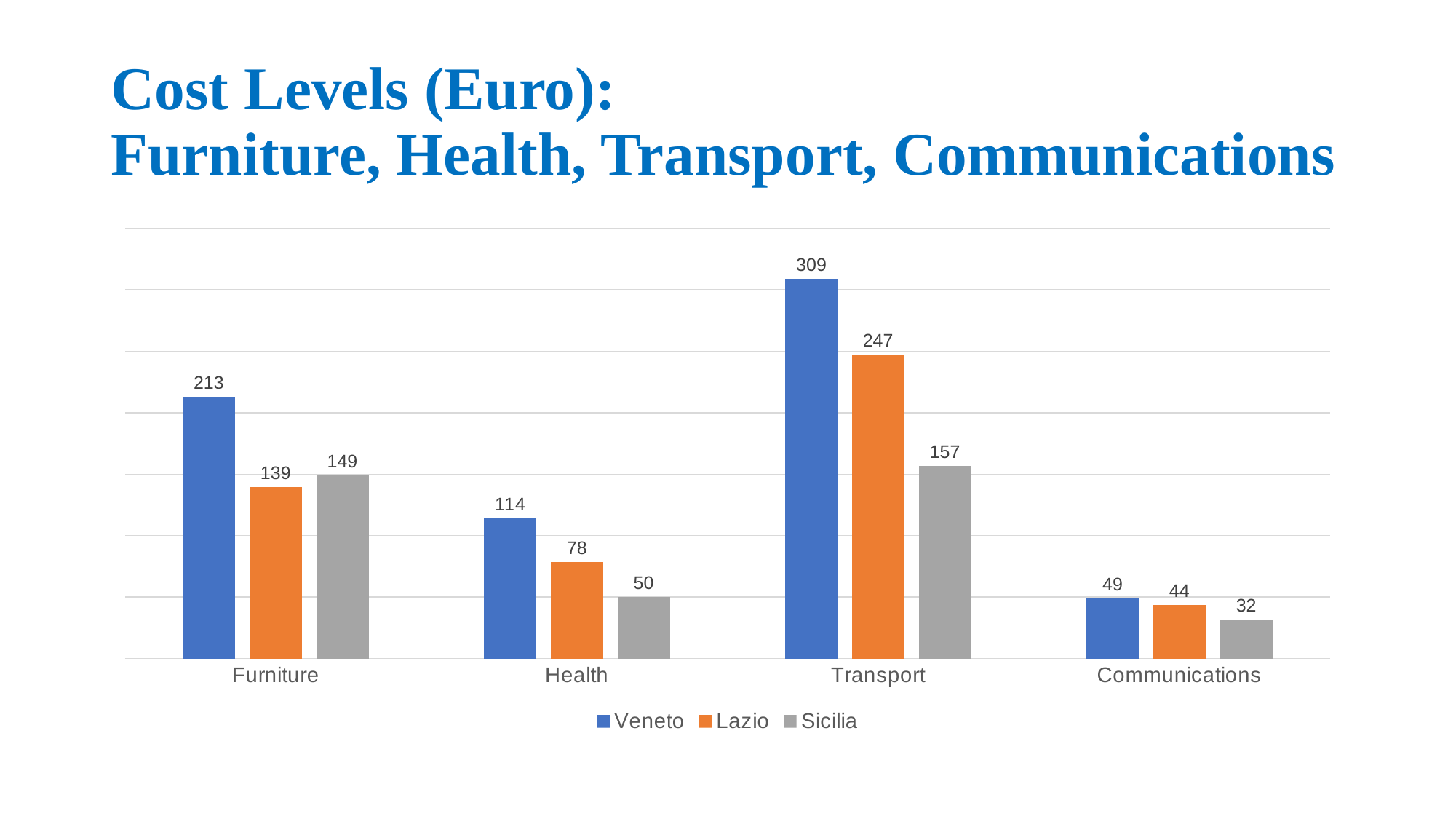
Which series is shown in orange in the legend? Lazio What kind of chart is shown on the slide? Bar chart What is the value for Sicilia in the Communications category? 32 What is the difference between the Veneto and Lazio values in the Transport category? 62 What is the value for Lazio in the Health category? 78 How many categories are shown on the x axis? 4 Which category has the lowest value for Lazio? Communications Which is larger in the Furniture category, the Lazio value or the Sicilia value? Sicilia How many series does the legend list? 3 What is the value for Veneto in the Transport category? 309 What is the value for Sicilia in the Furniture category? 149 Which category has the highest value for Veneto? Transport